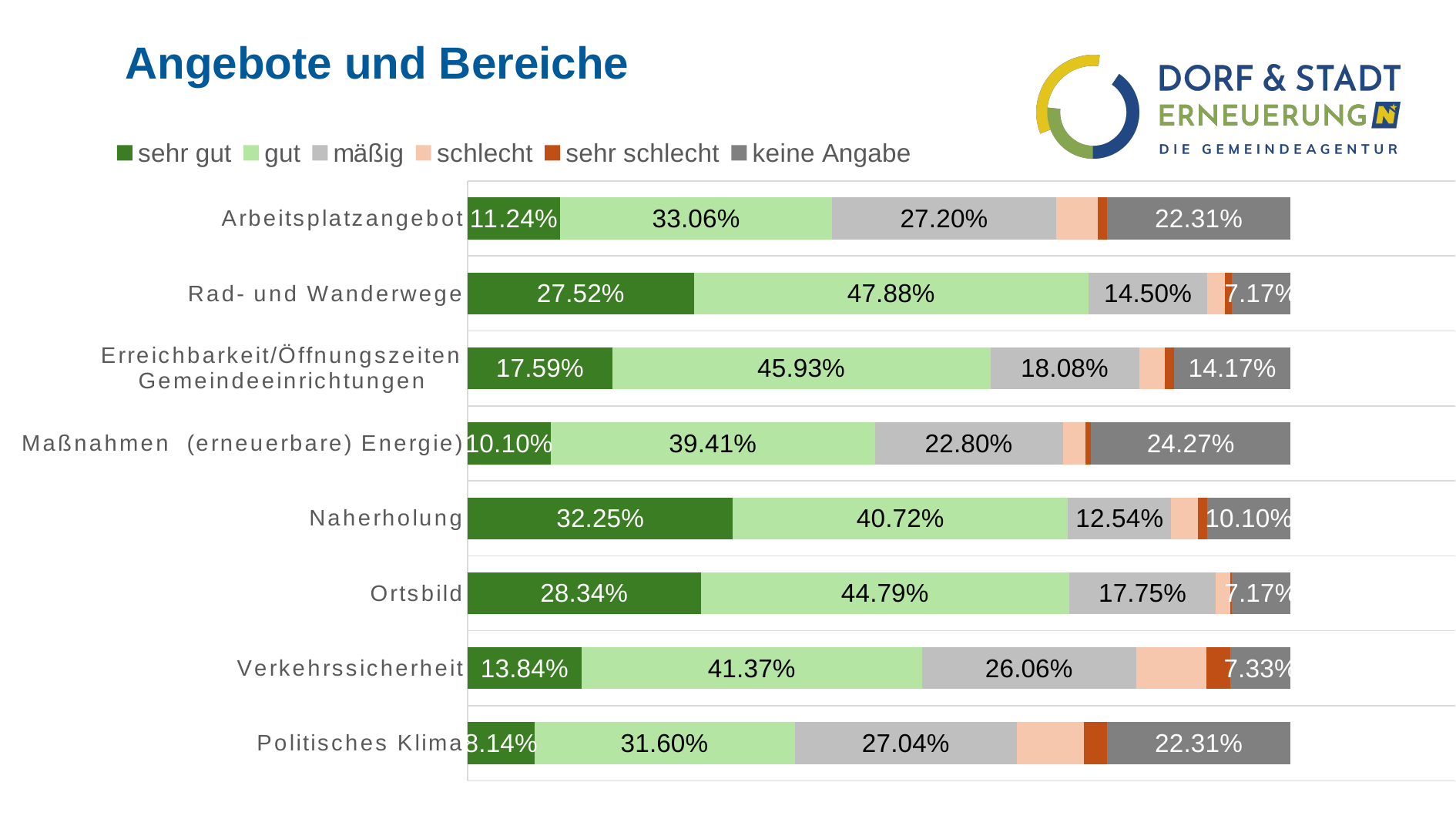
How much larger is the "sehr gut" share for Naherholung than for Ortsbild? 3.91 percentage points Which category has the lowest "sehr gut" share? Politisches Klima What is the "mäßig" value for Verkehrssicherheit? 26.06% How many categories (bars) are shown in the chart? 8 Which has a larger "sehr gut" share: Verkehrssicherheit or Arbeitsplatzangebot? Verkehrssicherheit Which category has the highest "keine Angabe" share? Maßnahmen (erneuerbare) Energie What percentage of respondents rated Rad- und Wanderwege as "gut"? 47.88% How many series does the legend list? 6 Which category has the highest "sehr gut" share? Naherholung What type of chart is shown on the slide? Stacked bar chart What is the "sehr gut" value for Naherholung? 32.25% What is the "keine Angabe" share for Politisches Klima? 22.31%